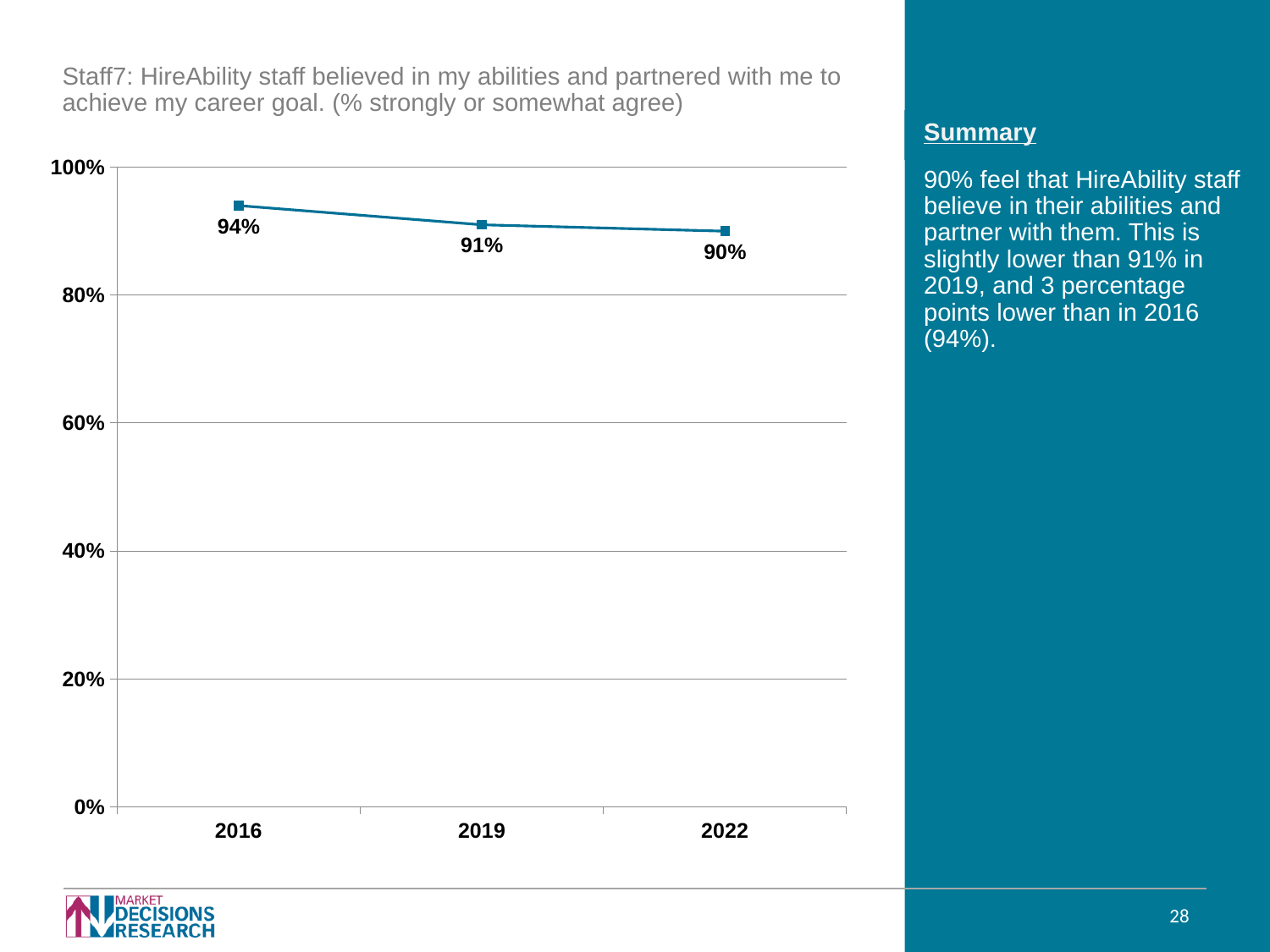
How many years are plotted on the chart? 3 What is the difference between the 2016 and 2022 values? 4% What is the value for 2016? 94% What is the value for 2022? 90% Which year has the highest value? 2016 What is the difference between the 2016 and 2019 values? 3% What kind of chart is shown on the slide? line chart Is the value for 2022 greater or less than 80%? greater Which is larger, the value for 2016 or the value for 2019? 2016 Do the values rise or fall from 2016 to 2022? fall Which year has the lowest value? 2022 What is the value for 2019? 91%